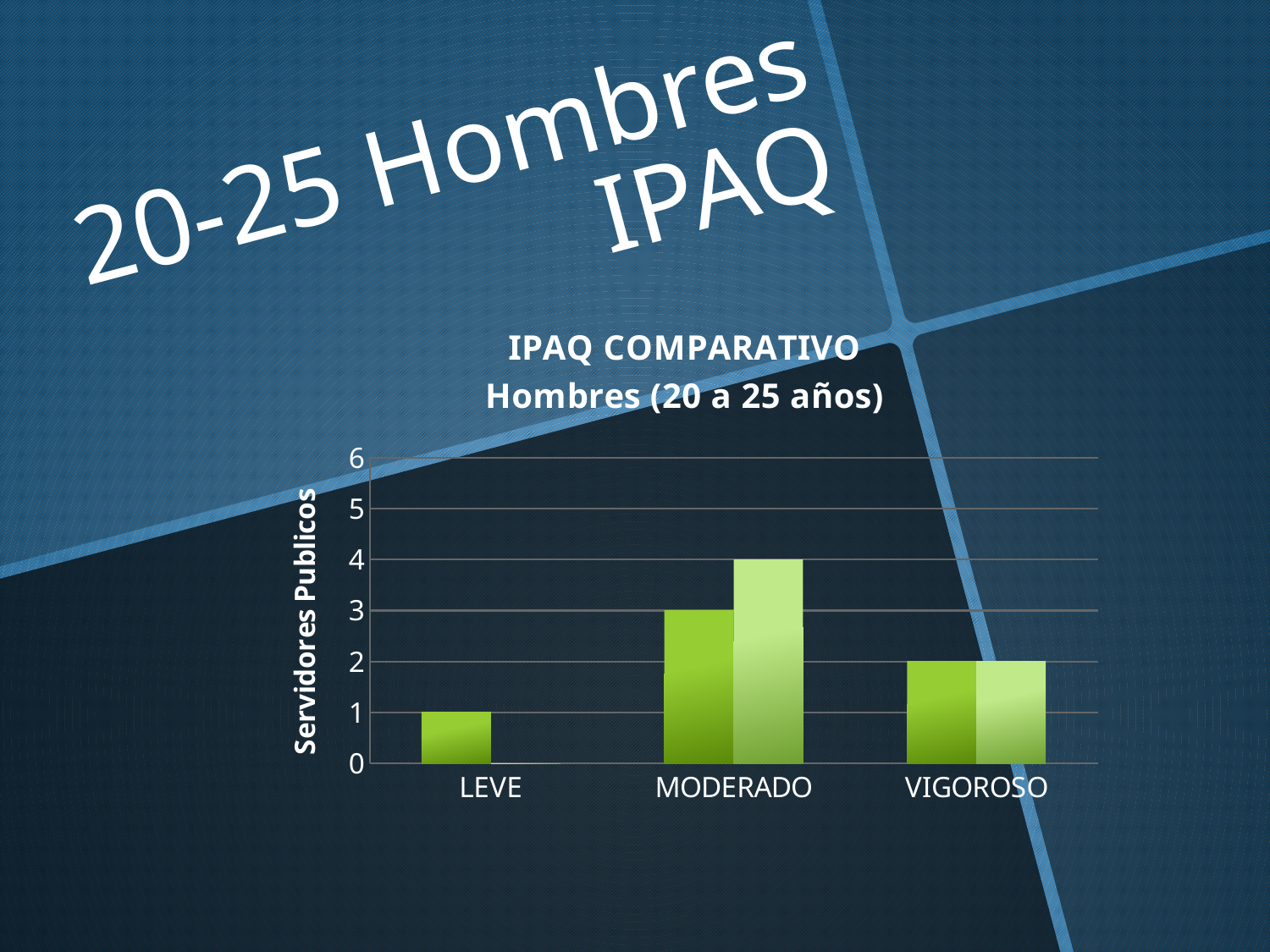
Which category has the lowest dark green bar? LEVE Is the light green bar for MODERADO greater or less than 3? greater What is the value of the dark green bar for MODERADO? 3 What is the difference between the light green and dark green bars for MODERADO? 1 What type of chart is shown on the slide? bar chart Which is larger, the dark green bar for MODERADO or the dark green bar for VIGOROSO? MODERADO Which category has the tallest bar in the chart? MODERADO What is the value of the dark green bar for LEVE? 1 How many categories are shown on the x axis of the chart? 3 What is the value of the dark green bar for VIGOROSO? 2 What is the value of the light green bar for MODERADO? 4 What is the title of the vertical axis of the chart? Servidores Publicos